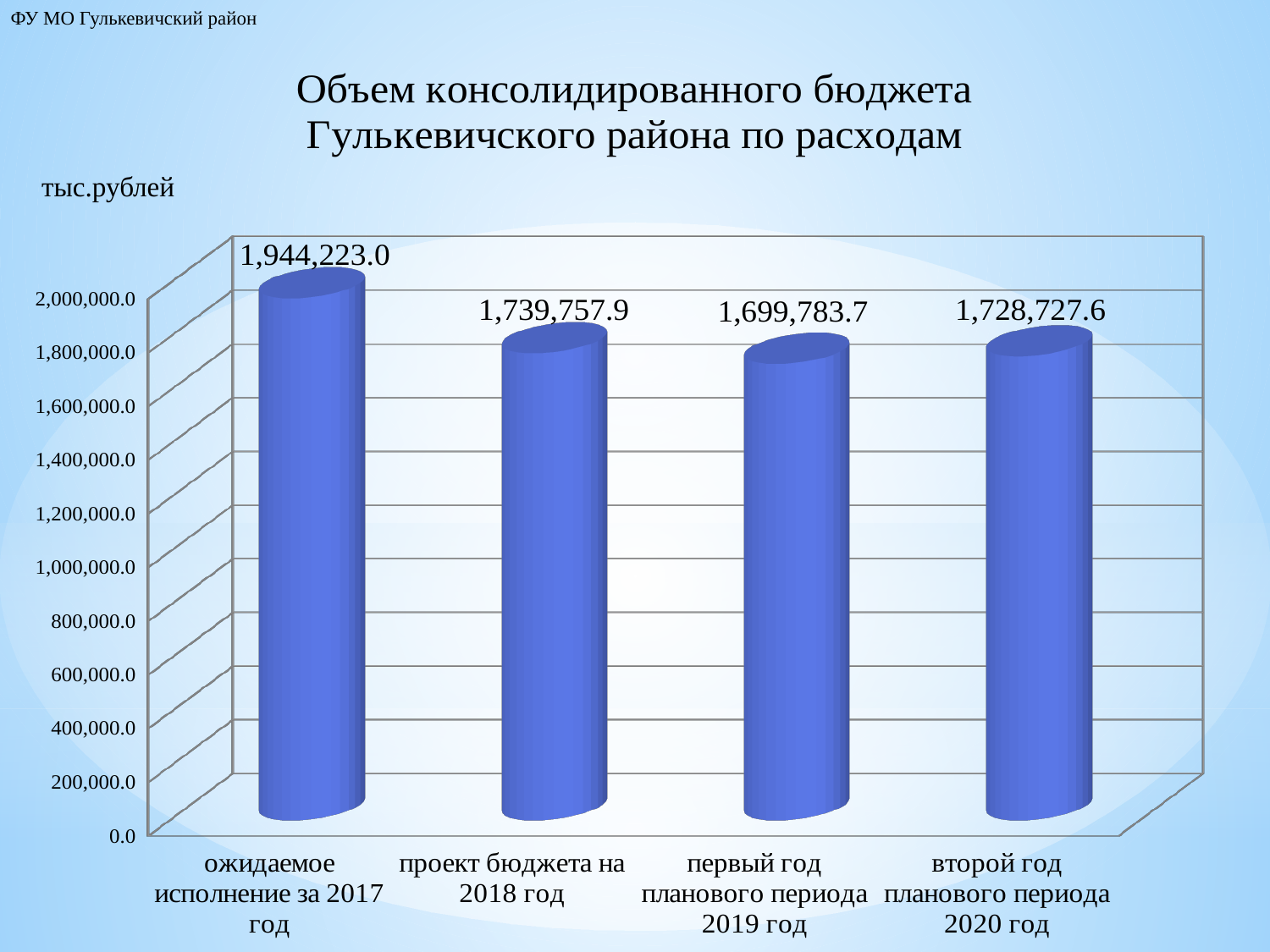
What is the difference between the values for 2017 and 2018? 204,465.1 What is the value for 'проект бюджета на 2018 год'? 1,739,757.9 Which category has the highest value? ожидаемое исполнение за 2017 год What is the value for 'первый год планового периода 2019 год'? 1,699,783.7 Which category has the lowest value? первый год планового периода 2019 год How many categories are shown in the chart? 4 Is the value for 2019 greater or less than 1,800,000.0? less What is the value for 'ожидаемое исполнение за 2017 год'? 1,944,223.0 What is the difference between the values for 2020 and 2019? 28,943.9 What is the value for 'второй год планового периода 2020 год'? 1,728,727.6 Which is larger, the value for 2018 or the value for 2020? 2018 What kind of chart is shown on the slide? bar chart